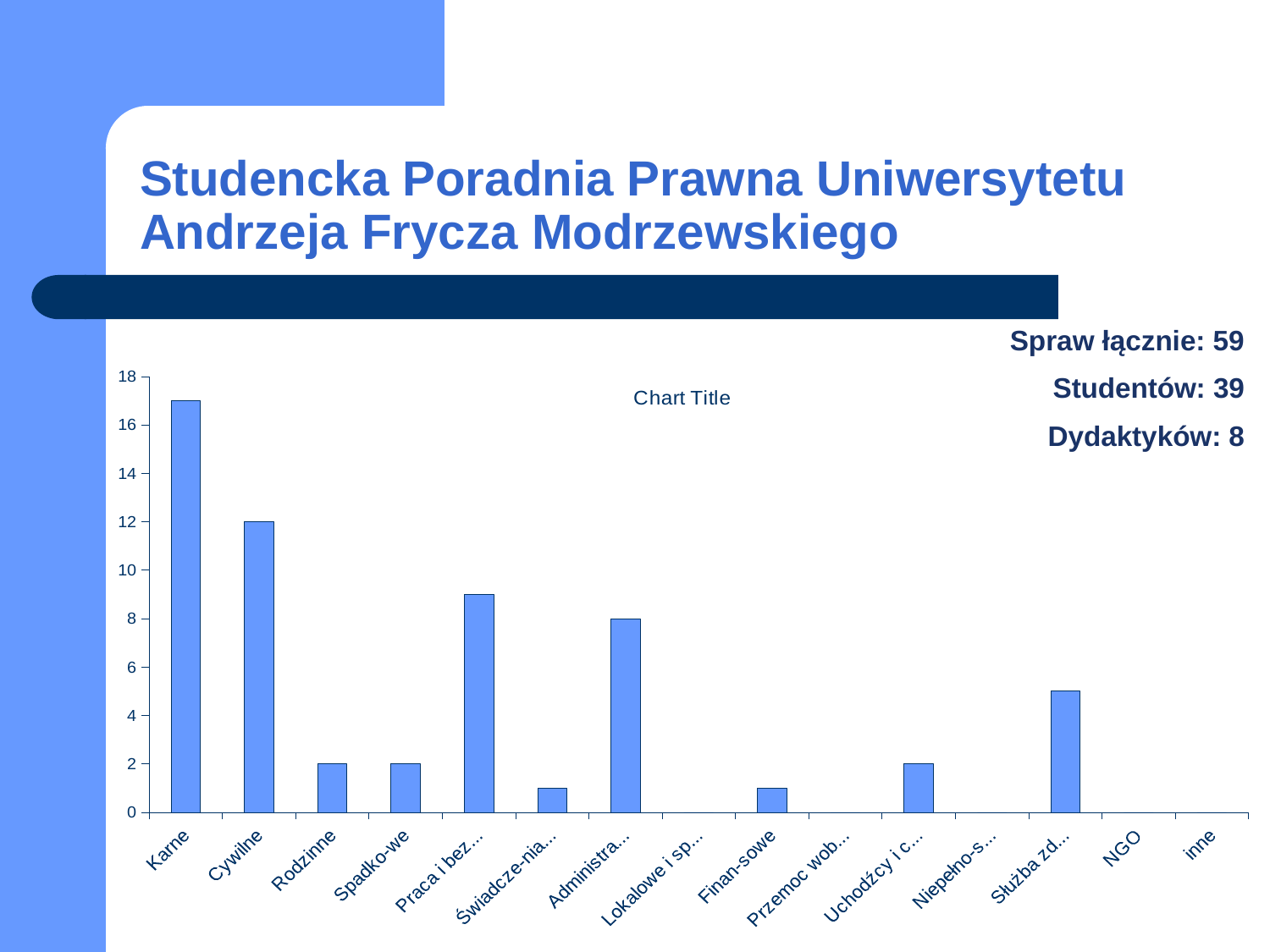
Is the value for Praca i bez... greater or less than 10? less What is the value for NGO? 0 What is the difference between the values for Cywilne and Administra...? 4 How many categories are shown on the x axis? 15 What kind of chart is shown on the slide? bar chart Which is larger, the value for Cywilne or the value for Administra...? Cywilne Which category has the highest bar? Karne What is the value for Cywilne? 12 What is the value for Rodzinne? 2 Is the value for Karne greater or less than 16? greater What is the value for Administra...? 8 Is the value for Służba zd... greater or less than 4? greater